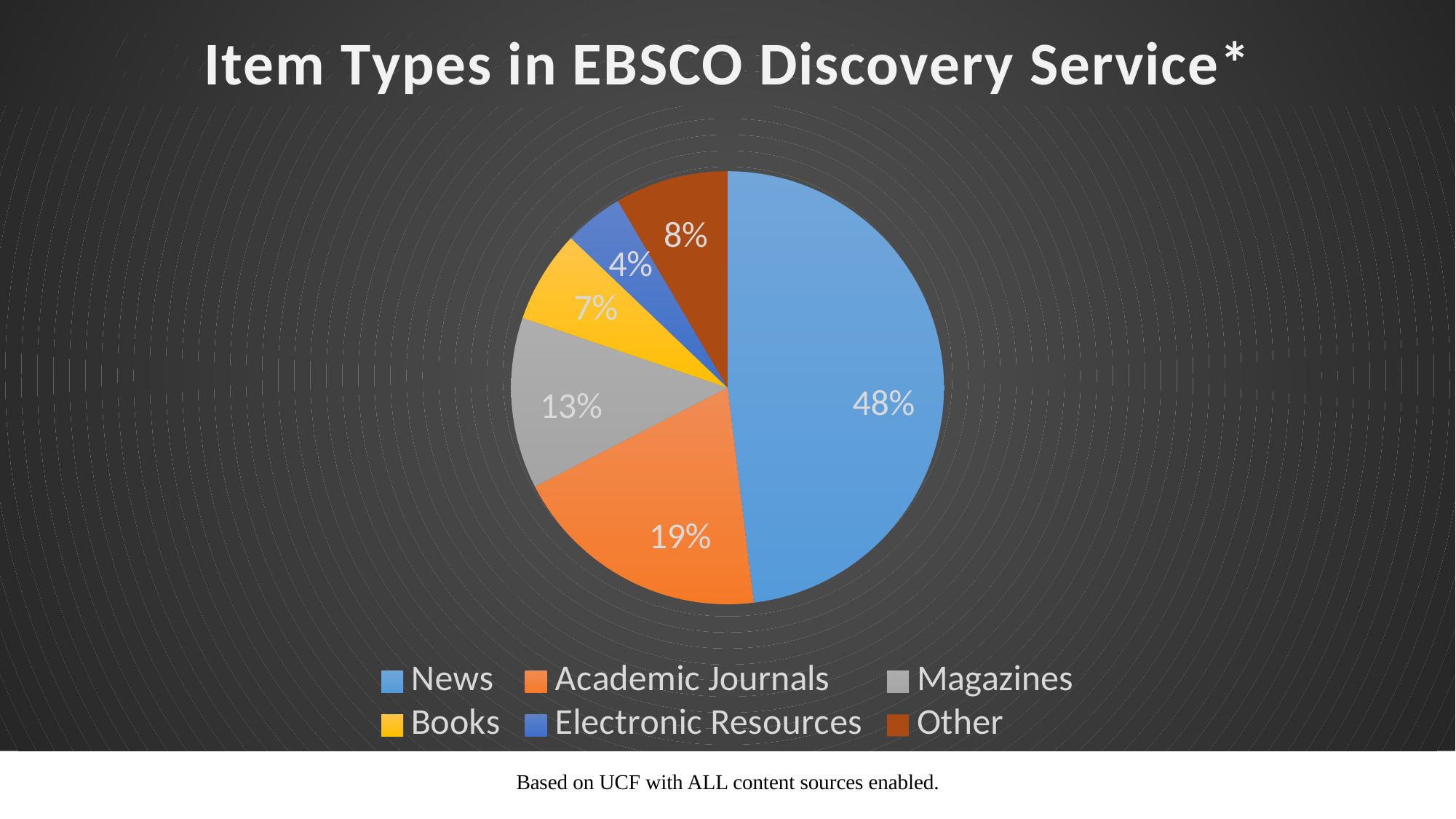
What percentage is shown for Magazines? 13% Which item type has the smallest slice of the pie? Electronic Resources How many item types are shown in the pie chart? 6 What share of the pie does News account for? 48% Which is larger, the share for Magazines or the share for Other? Magazines What kind of chart is shown on the slide? Pie chart What percentage is shown for Electronic Resources? 4% What percentage is shown for Other? 8% What percentage is shown for Academic Journals? 19% Which item type has the largest slice of the pie? News What is the difference in percentage points between News and Academic Journals? 29 What percentage is shown for Books? 7%